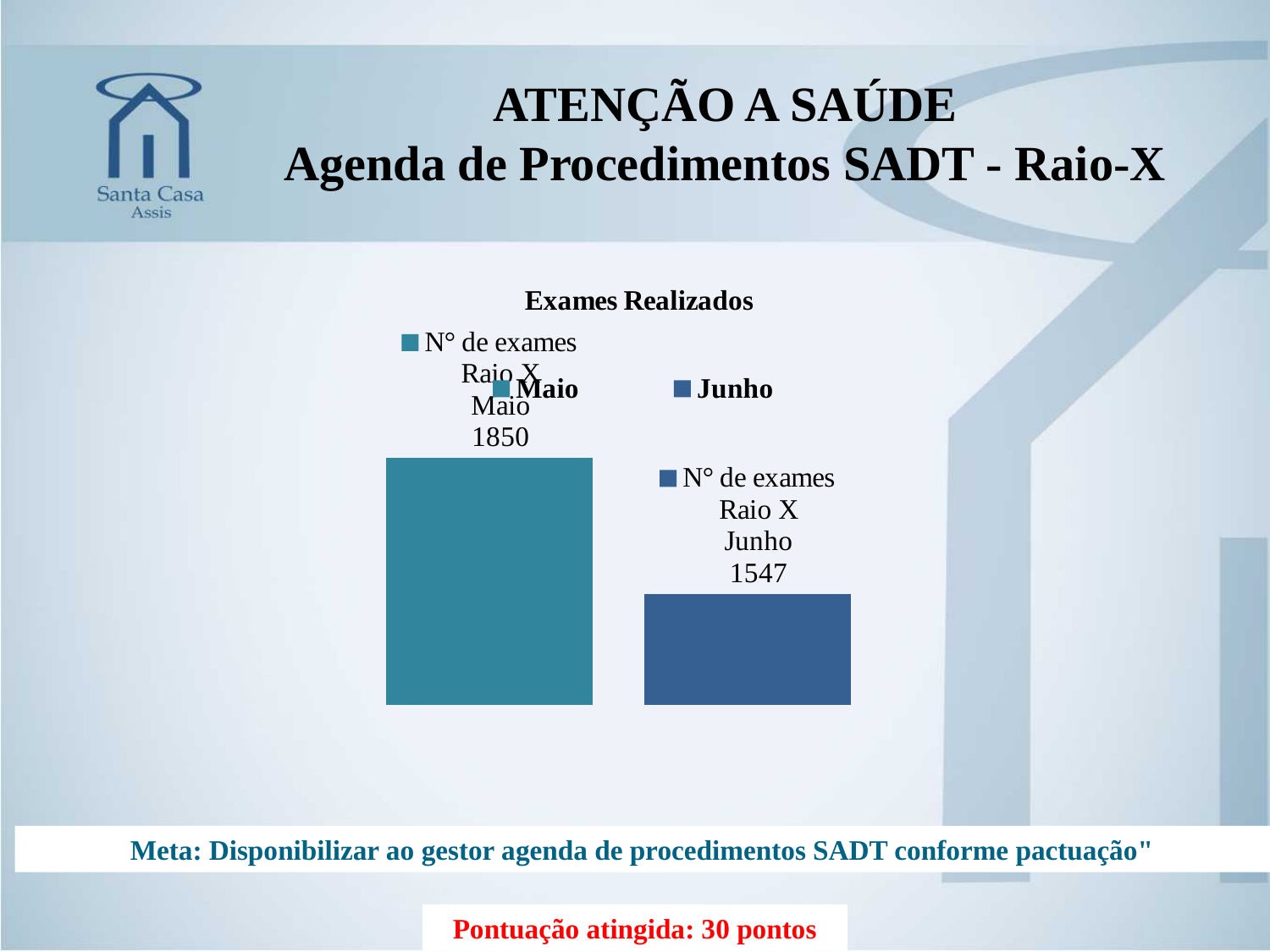
Which month has the higher number of exams in the Exames Realizados chart? Maio What kind of chart is shown on the slide? bar chart How many entries does the legend of the Exames Realizados chart list? 2 Do the values rise or fall from Maio to Junho in the Exames Realizados chart? fall What is the title of the chart on the slide? Exames Realizados What is the difference between the number of exams in Maio and Junho? 303 How many bars are plotted in the Exames Realizados chart? 2 What is the number of Raio X exams for Maio in the Exames Realizados chart? 1850 Is the value for Maio larger or smaller than the value for Junho? larger What are the two legend entries in the Exames Realizados chart? Maio and Junho Which month has the lower number of exams in the Exames Realizados chart? Junho What is the number of Raio X exams for Junho in the Exames Realizados chart? 1547